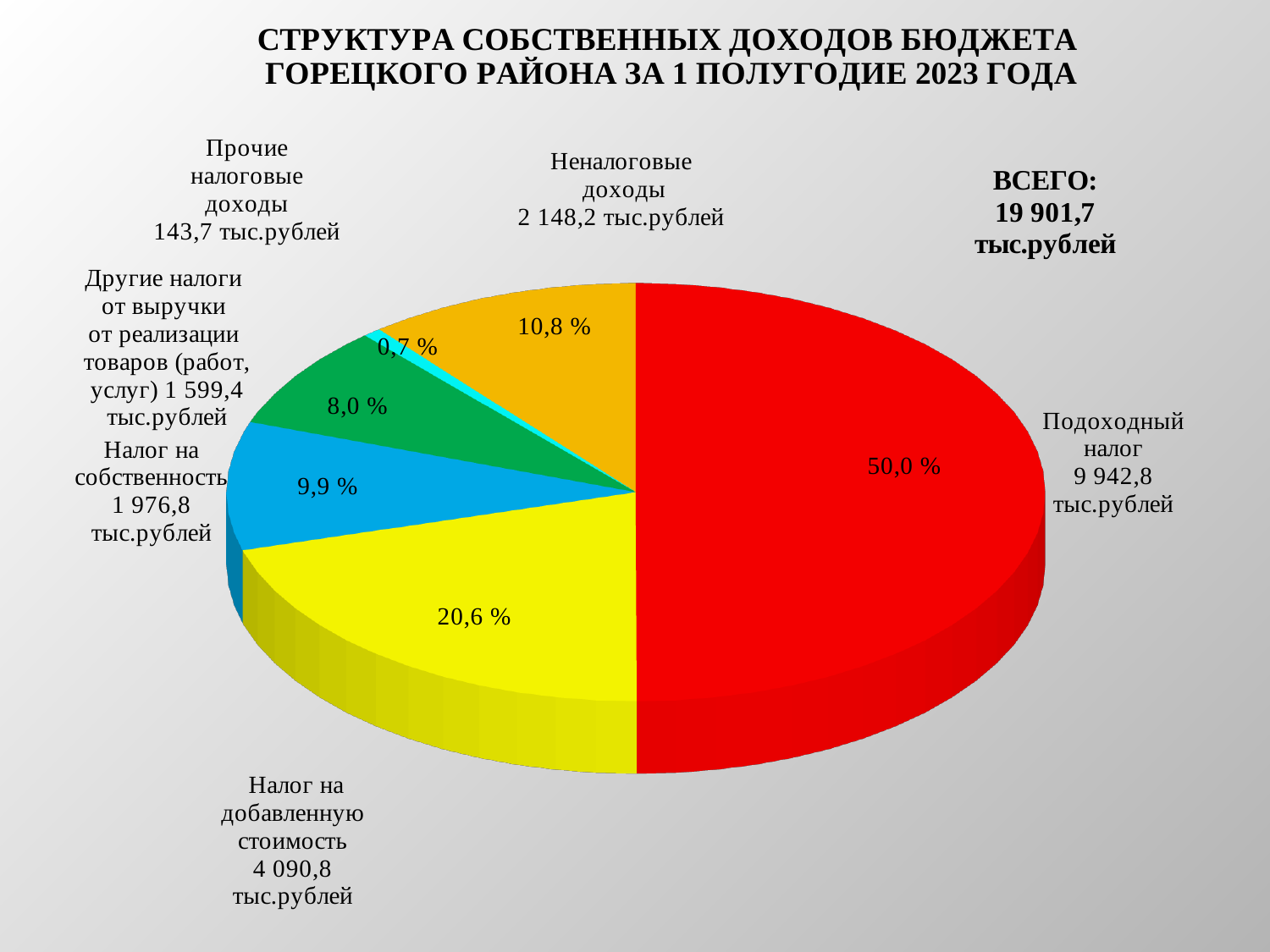
Which category has the largest slice of the pie? Подоходный налог Which category has the smallest slice of the pie? Прочие налоговые доходы What is the amount shown for Налог на собственность? 1 976,8 тыс.рублей What kind of chart is shown on the slide? Pie chart What share of the pie does Неналоговые доходы have? 10,8 % What share of the pie does Налог на добавленную стоимость have? 20,6 % Which is larger: the share for Налог на собственность or the share for Другие налоги от выручки от реализации товаров (работ, услуг)? Налог на собственность What total amount (ВСЕГО) is shown on the slide? 19 901,7 тыс.рублей What is the difference in percentage points between the share of Подоходный налог and the share of Налог на добавленную стоимость? 29,4 How many slices does the pie chart have? 6 What share of the pie does Подоходный налог have? 50,0 % What is the amount shown for Прочие налоговые доходы? 143,7 тыс.рублей